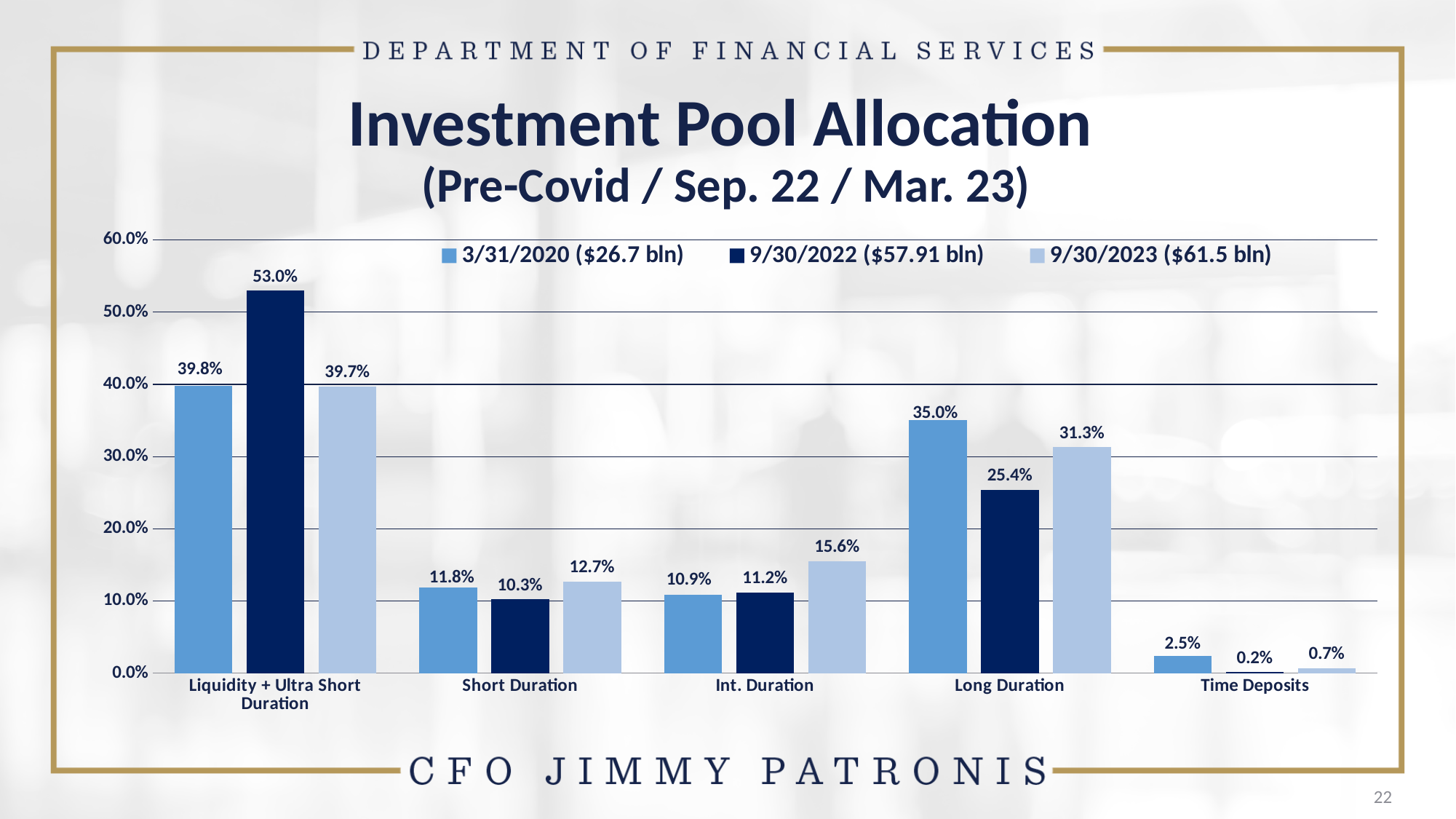
What is the value for Long Duration in the 9/30/2023 ($61.5 bln) series? 31.3% Which is larger for Long Duration: the 3/31/2020 ($26.7 bln) value or the 9/30/2022 ($57.91 bln) value? 3/31/2020 ($26.7 bln) Which category has the lowest value in the 9/30/2023 ($61.5 bln) series? Time Deposits How many series does the legend list? 3 Which category has the highest value in the 9/30/2022 ($57.91 bln) series? Liquidity + Ultra Short Duration What is the value for Liquidity + Ultra Short Duration in the 9/30/2022 ($57.91 bln) series? 53.0% How many categories are shown on the x axis? 5 What is the title of the chart? Investment Pool Allocation (Pre-Covid / Sep. 22 / Mar. 23) What is the value for Time Deposits in the 3/31/2020 ($26.7 bln) series? 2.5% Is the value for Int. Duration in the 9/30/2023 ($61.5 bln) series greater or less than 20.0%? less What kind of chart is shown on the slide? Bar chart What is the difference between the 9/30/2022 ($57.91 bln) and 3/31/2020 ($26.7 bln) values for Liquidity + Ultra Short Duration? 13.2%